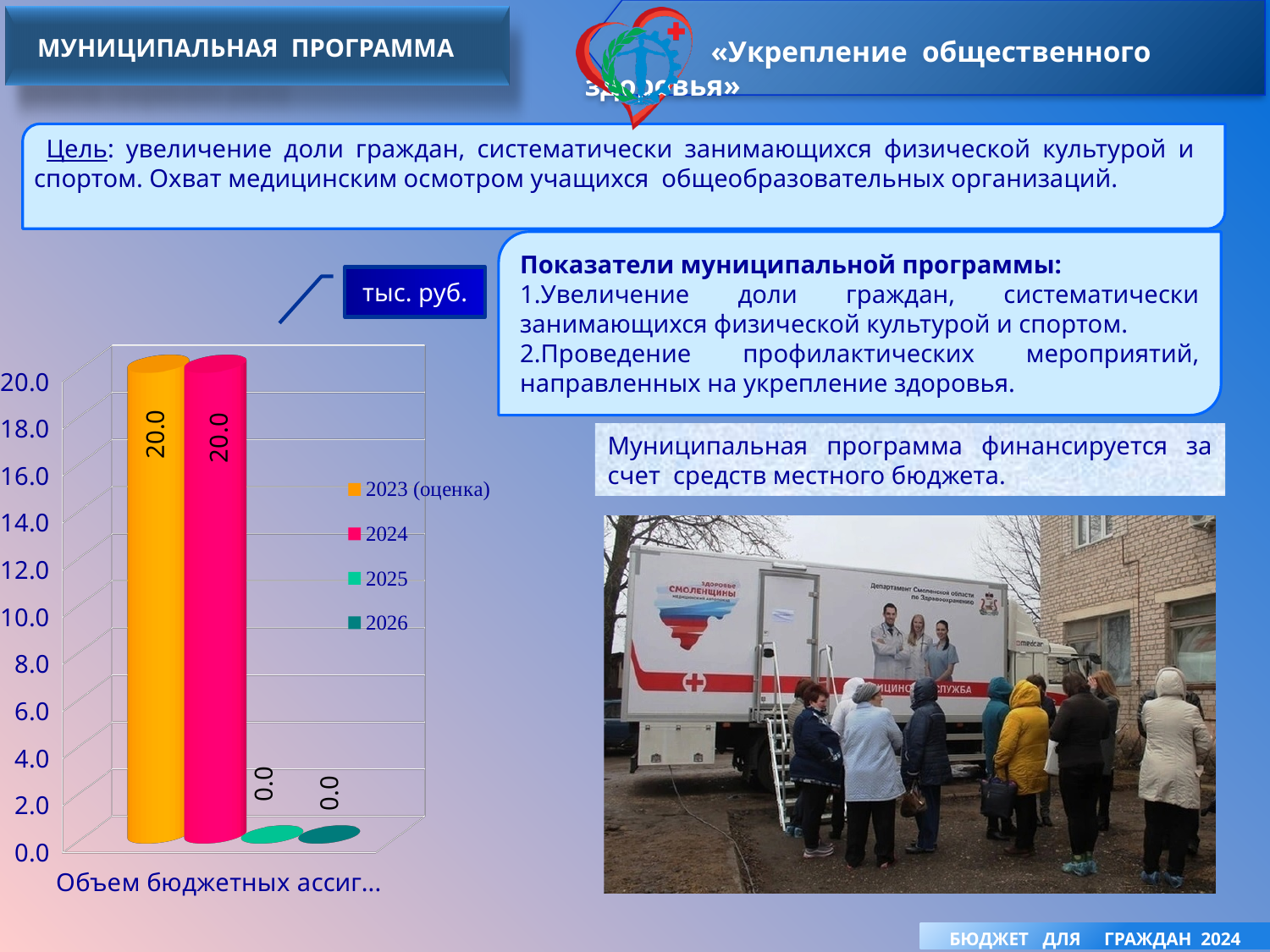
What is the difference between the values for 2024 and 2025 in the chart? 20.0 What kind of chart is shown on the slide? bar chart Which is larger in the chart, the value for 2023 (оценка) or the value for 2026? 2023 (оценка) How many series does the chart legend list? 4 What is the value for the 2024 series in the chart? 20.0 Is the value for 2024 in the chart greater or less than 10.0? greater What is the value for the 2025 series in the chart? 0.0 What is the highest value shown on the chart's vertical axis? 20.0 What unit of measurement is indicated for the chart values? тыс. руб. What is the value for the 2026 series in the chart? 0.0 What is the difference between the values for 2023 (оценка) and 2024 in the chart? 0.0 What is the value for the 2023 (оценка) series in the chart? 20.0